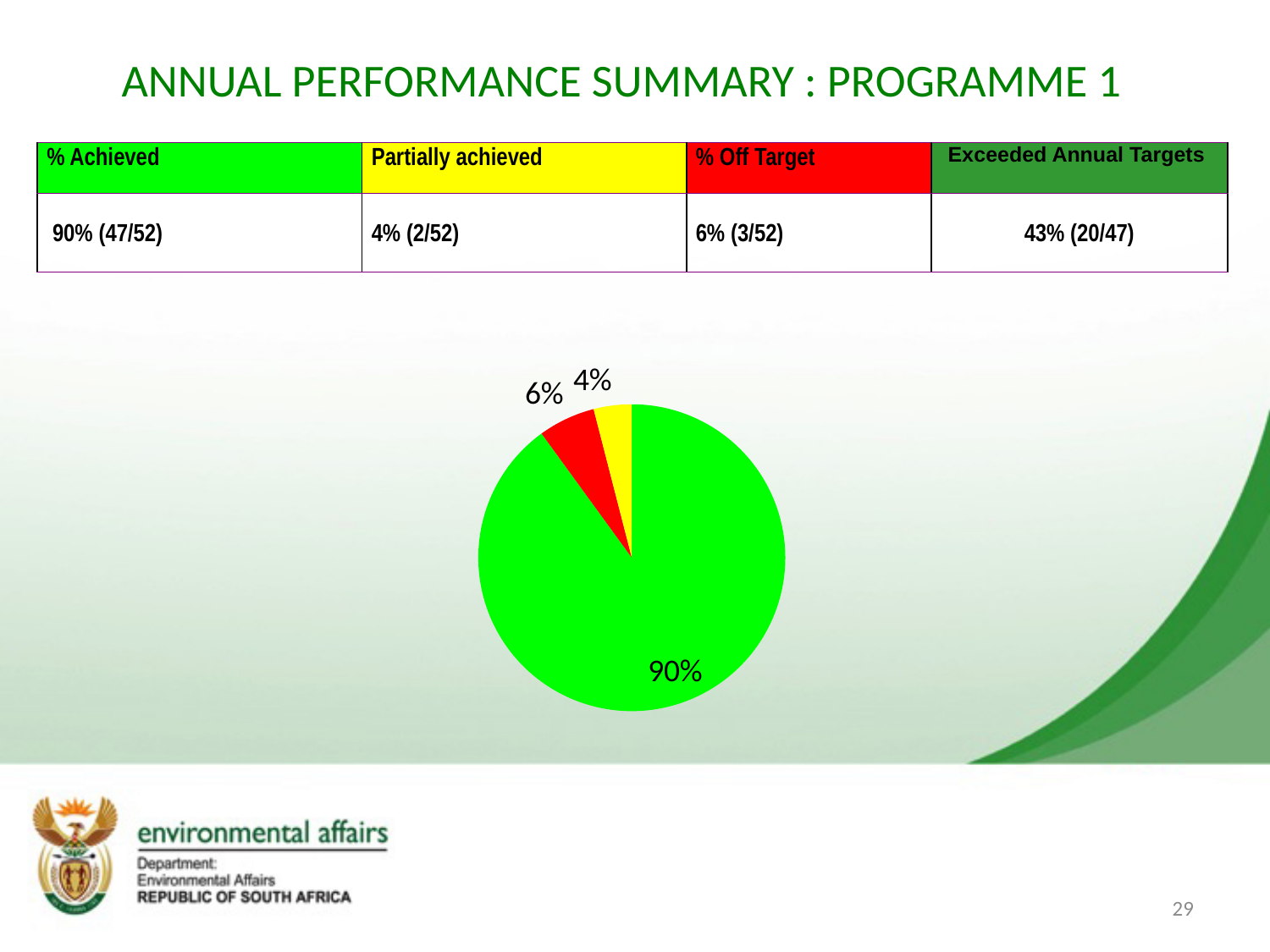
Which slice of the pie chart is the smallest? the yellow slice (4%) How many slices does the pie chart have? 3 What is the difference between the green slice and the red slice in the pie chart? 84% What percentage is shown on the red slice of the pie chart? 6% Which slice of the pie chart is the largest? the green slice (90%) What share of the pie does the green slice represent? 90% What colour is the largest slice of the pie chart? green Which is larger in the pie chart, the red slice or the yellow slice? the red slice What kind of chart is shown on the slide? pie chart What is the difference between the red slice and the yellow slice in the pie chart? 2% What percentage is shown on the green slice of the pie chart? 90% What percentage is shown on the yellow slice of the pie chart? 4%